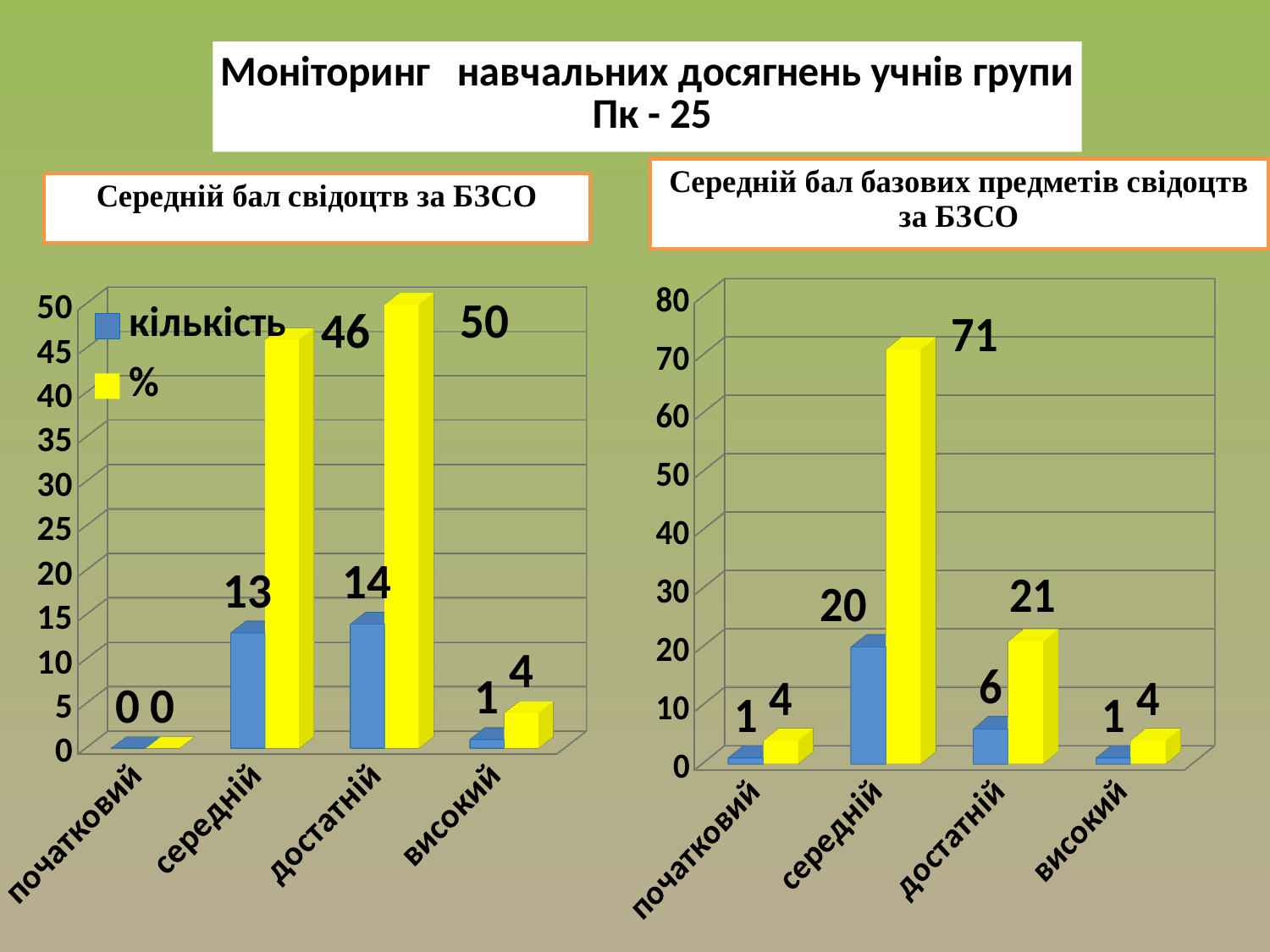
In the left chart (Середній бал свідоцтв за БЗСО), what is the % value for середній? 46 In the left chart (Середній бал свідоцтв за БЗСО), which category has the highest % value? достатній What type of chart is the right chart (Середній бал базових предметів свідоцтв за БЗСО)? bar chart In the left chart (Середній бал свідоцтв за БЗСО), how many series does the legend list? 2 In the right chart (Середній бал базових предметів свідоцтв за БЗСО), which category has the lowest % value? початковий and високий (both 4) In the right chart (Середній бал базових предметів свідоцтв за БЗСО), which is larger: the кількість value for середній or for достатній? середній In the right chart (Середній бал базових предметів свідоцтв за БЗСО), what is the difference between the % values for середній and достатній? 50 In the left chart (Середній бал свідоцтв за БЗСО), what is the кількість value for достатній? 14 In the right chart (Середній бал базових предметів свідоцтв за БЗСО), what is the кількість value for достатній? 6 How many categories are shown on the x axis of the left chart (Середній бал свідоцтв за БЗСО)? 4 In the right chart (Середній бал базових предметів свідоцтв за БЗСО), what is the % value for середній? 71 In the left chart (Середній бал свідоцтв за БЗСО), what is the difference between the % values for достатній and високий? 46